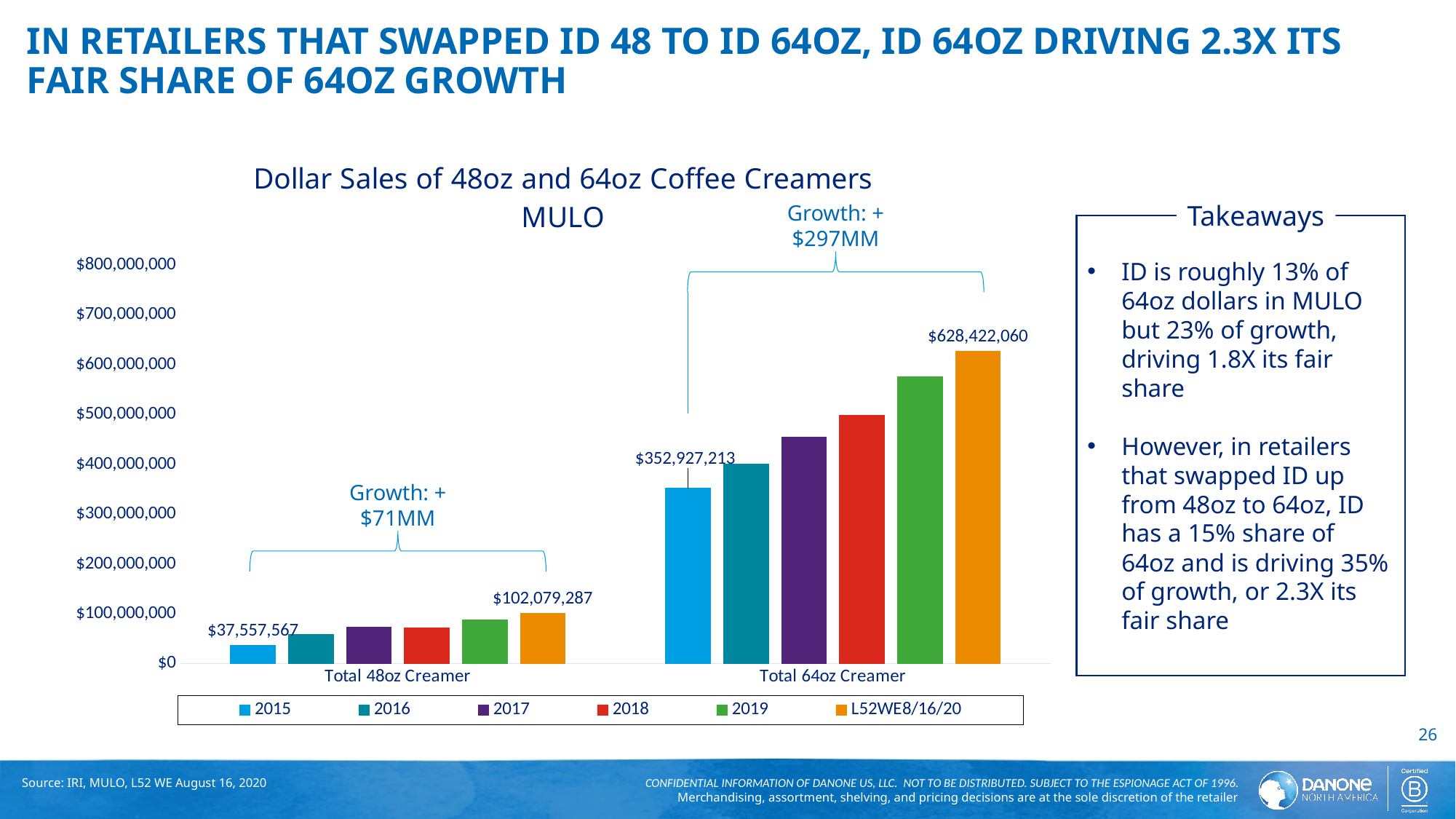
For Total 64oz Creamer, do the values rise or fall from 2015 to L52WE8/16/20? Rise Which is larger: the 2015 value for Total 64oz Creamer or the L52WE8/16/20 value for Total 48oz Creamer? 2015 value for Total 64oz Creamer What kind of chart is shown on the slide? Bar chart Is the 2019 value for Total 64oz Creamer greater or less than $500,000,000? greater How many categories are shown on the x axis? 2 What is the 2015 value for Total 64oz Creamer? $352,927,213 What is the difference between the L52WE8/16/20 and 2015 values for Total 64oz Creamer? $275,494,847 What is the 2015 value for Total 48oz Creamer? $37,557,567 How many series does the legend list? 6 What is the L52WE8/16/20 value for Total 48oz Creamer? $102,079,287 What is the L52WE8/16/20 value for Total 64oz Creamer? $628,422,060 What growth amount is annotated above the Total 64oz Creamer bars? + $297MM